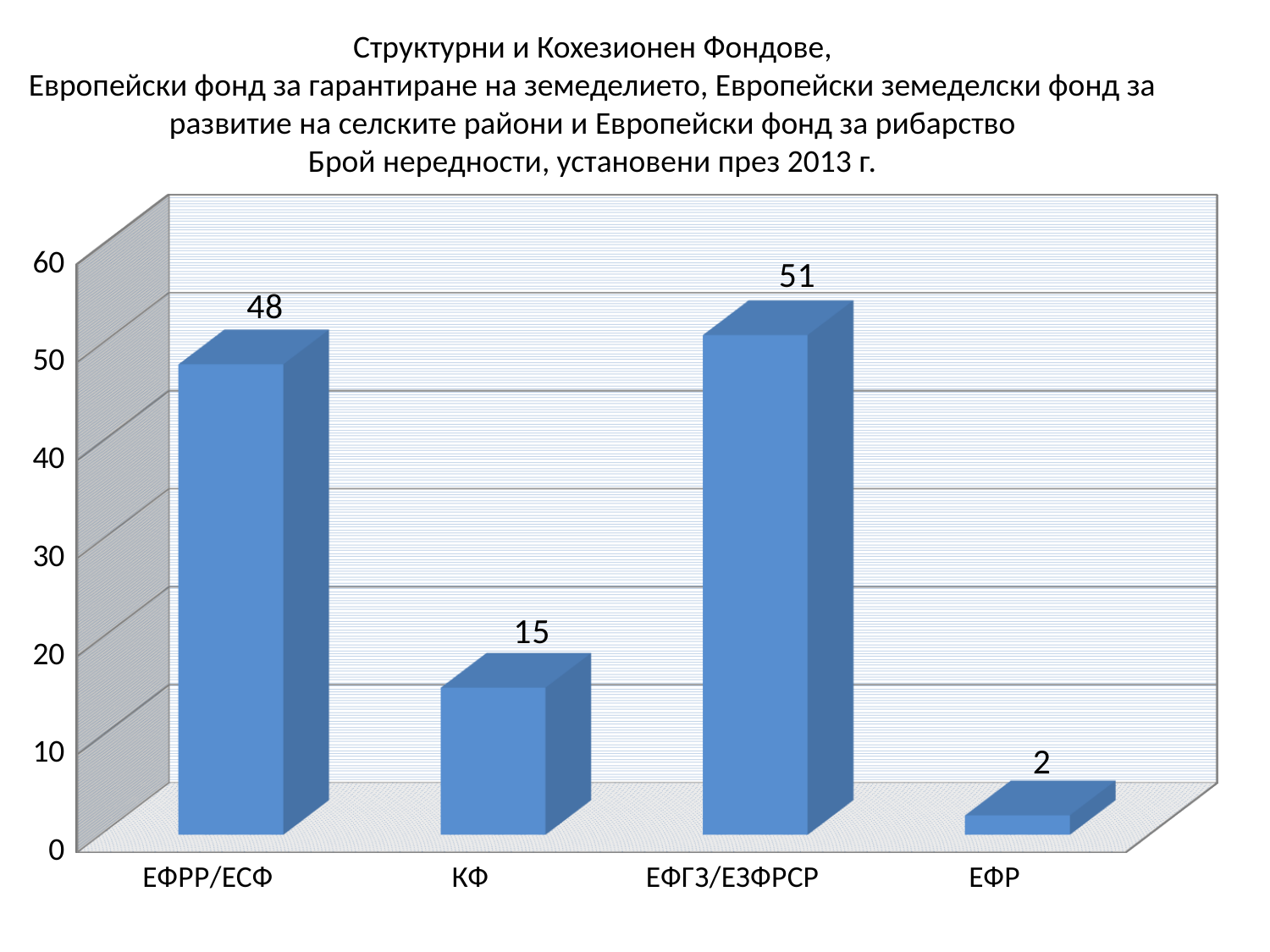
What is the value for ЕФГЗ/ЕЗФРСР? 51 What is the difference between the values for ЕФГЗ/ЕЗФРСР and ЕФРР/ЕСФ? 3 What is the value for КФ? 15 How many categories are shown on the x axis? 4 What is the difference between the values for КФ and ЕФР? 13 Which category has the lowest value? ЕФР What is the value for ЕФРР/ЕСФ? 48 What is the value for ЕФР? 2 Is the value for КФ greater or less than 20? less Which category has the highest value? ЕФГЗ/ЕЗФРСР Which is larger, the value for ЕФРР/ЕСФ or the value for КФ? ЕФРР/ЕСФ What kind of chart is shown on the slide? bar chart